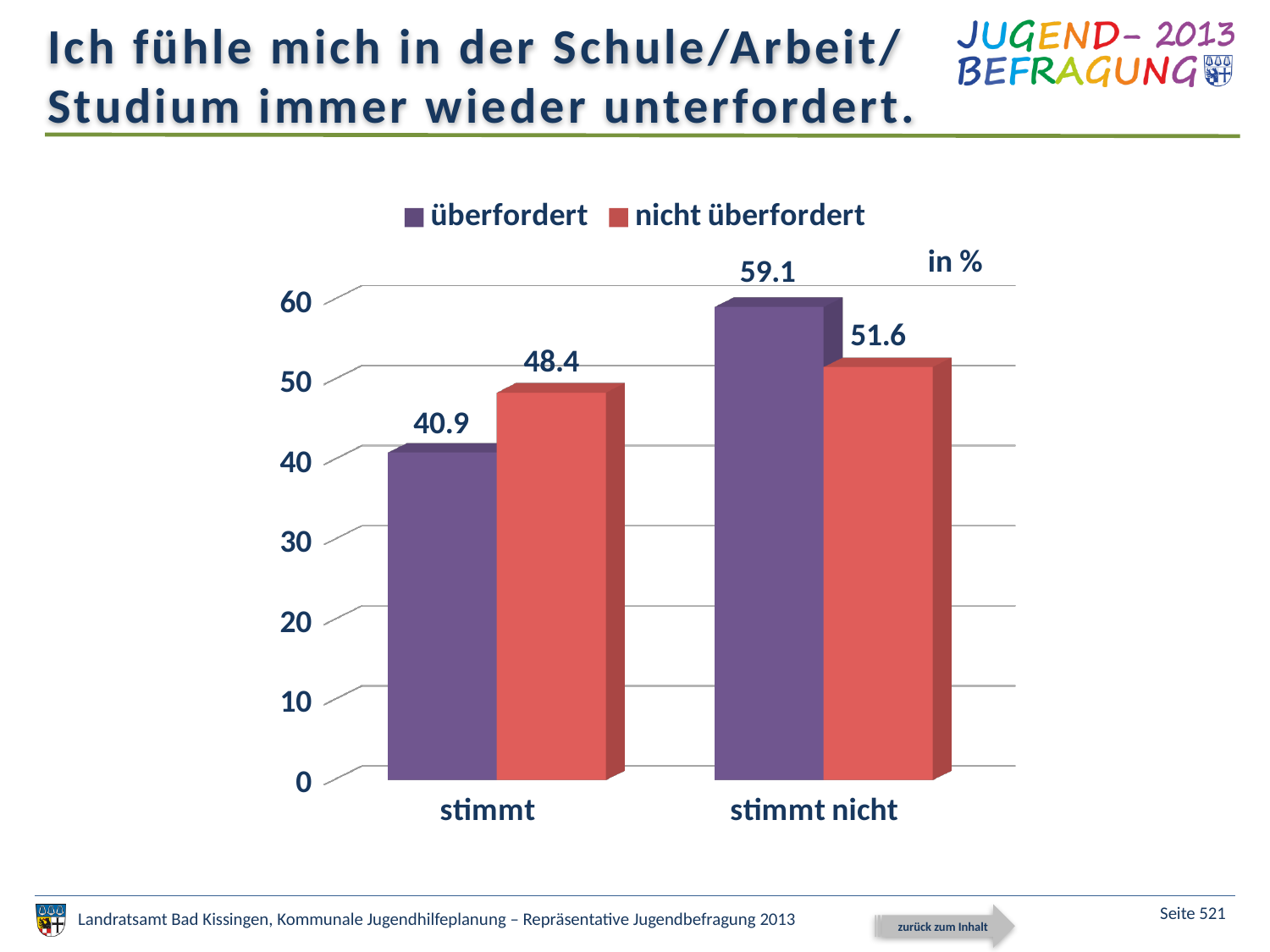
What is the value for "überfordert" in the "stimmt" category? 40.9 What kind of chart is shown on the slide? bar chart Which bar has the highest value in the chart? überfordert, stimmt nicht What is the value for "nicht überfordert" in the "stimmt" category? 48.4 What is the value for "nicht überfordert" in the "stimmt nicht" category? 51.6 What is the value for "überfordert" in the "stimmt nicht" category? 59.1 What is the difference between the "überfordert" and "nicht überfordert" values in the "stimmt nicht" category? 7.5 Which bar has the lowest value in the chart? überfordert, stimmt How many categories are shown on the x axis? 2 How many series does the legend list? 2 What unit is indicated for the values in the chart? in % In the "stimmt" category, which series has the larger value, "überfordert" or "nicht überfordert"? nicht überfordert